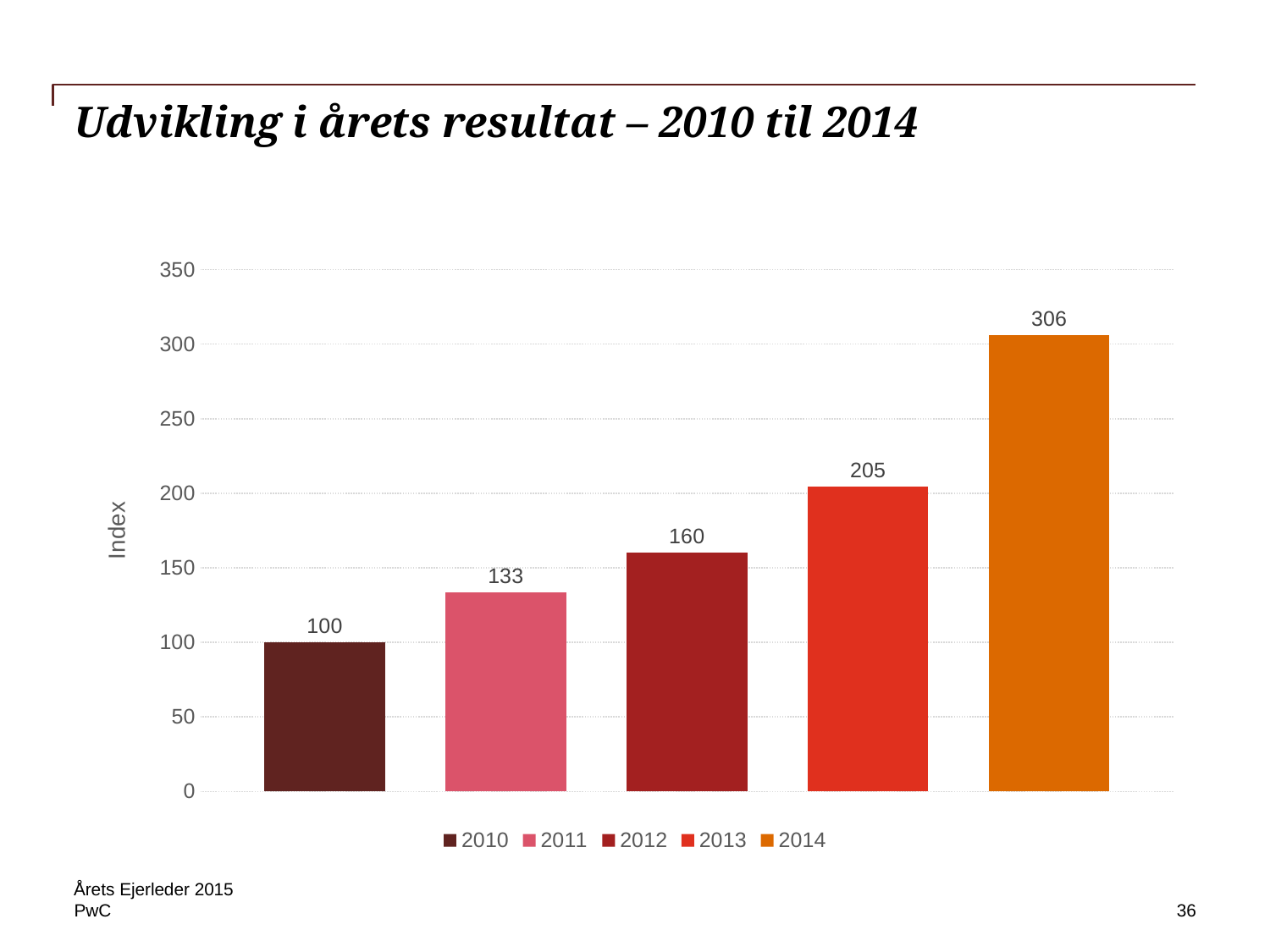
Which year has the highest index value? 2014 What kind of chart is shown on the slide? bar chart Which is larger, the index value for 2013 or for 2011? 2013 How many bars are shown in the chart? 5 What is the index value for 2011? 133 What is the index value for 2012? 160 What is the difference between the index values for 2013 and 2012? 45 What is the difference between the index values for 2014 and 2010? 206 Do the index values rise or fall from 2010 to 2014? rise What is the index value for 2014? 306 Which year has the lowest index value? 2010 Is the value for 2013 greater or less than 250? less